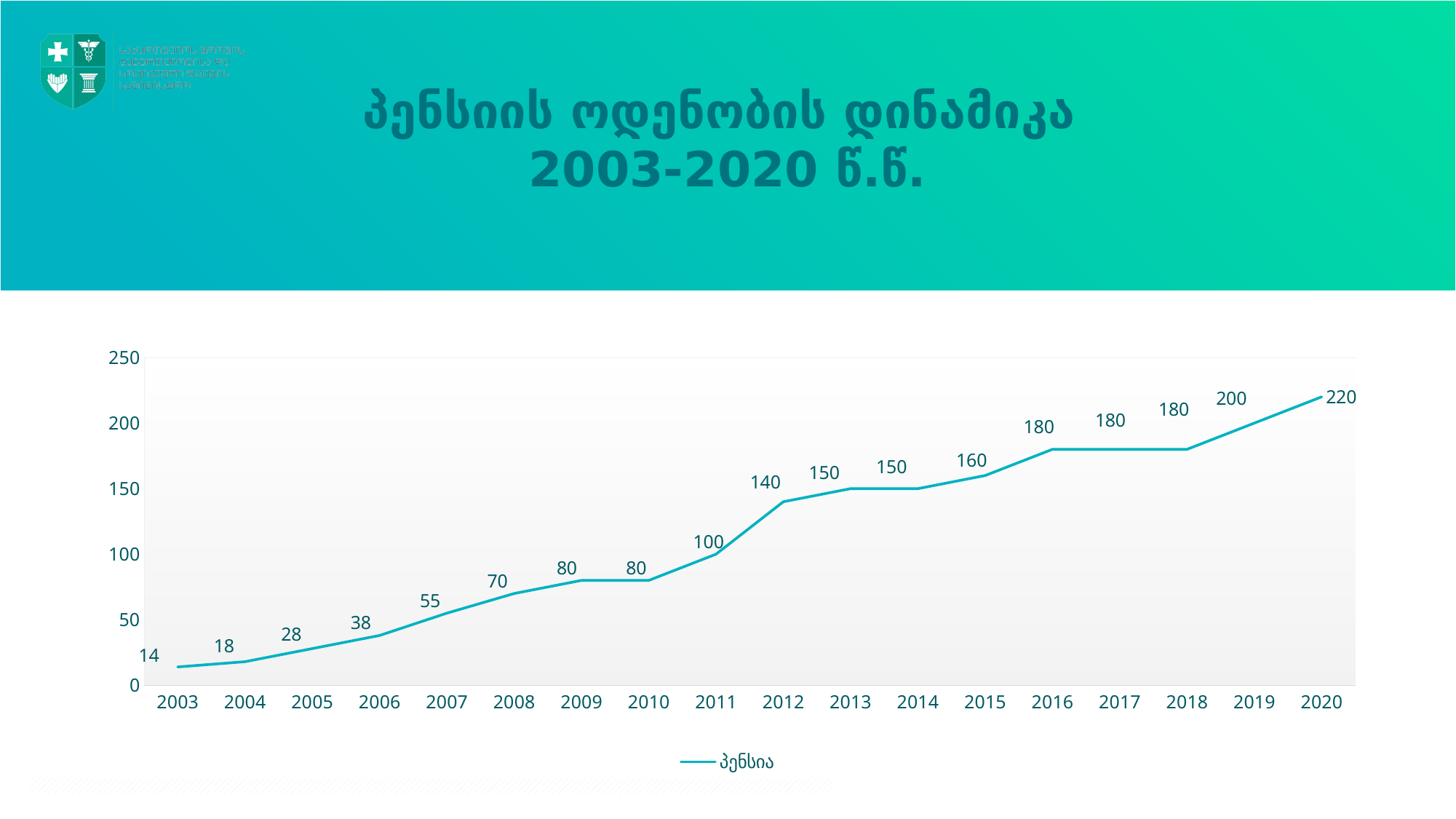
What is the difference between the values for 2012 and 2011? 40 Which year has the highest value? 2020 How many years are plotted on the x axis? 18 Do the values rise or fall from 2003 to 2020? rise What is the difference between the values for 2020 and 2003? 206 What is the value for 2012? 140 How many series does the legend list? 1 What is the value for 2003? 14 Which is larger, the value for 2008 or the value for 2010? 2010 What kind of chart is shown? line chart What is the value for 2020? 220 Which year has the lowest value? 2003